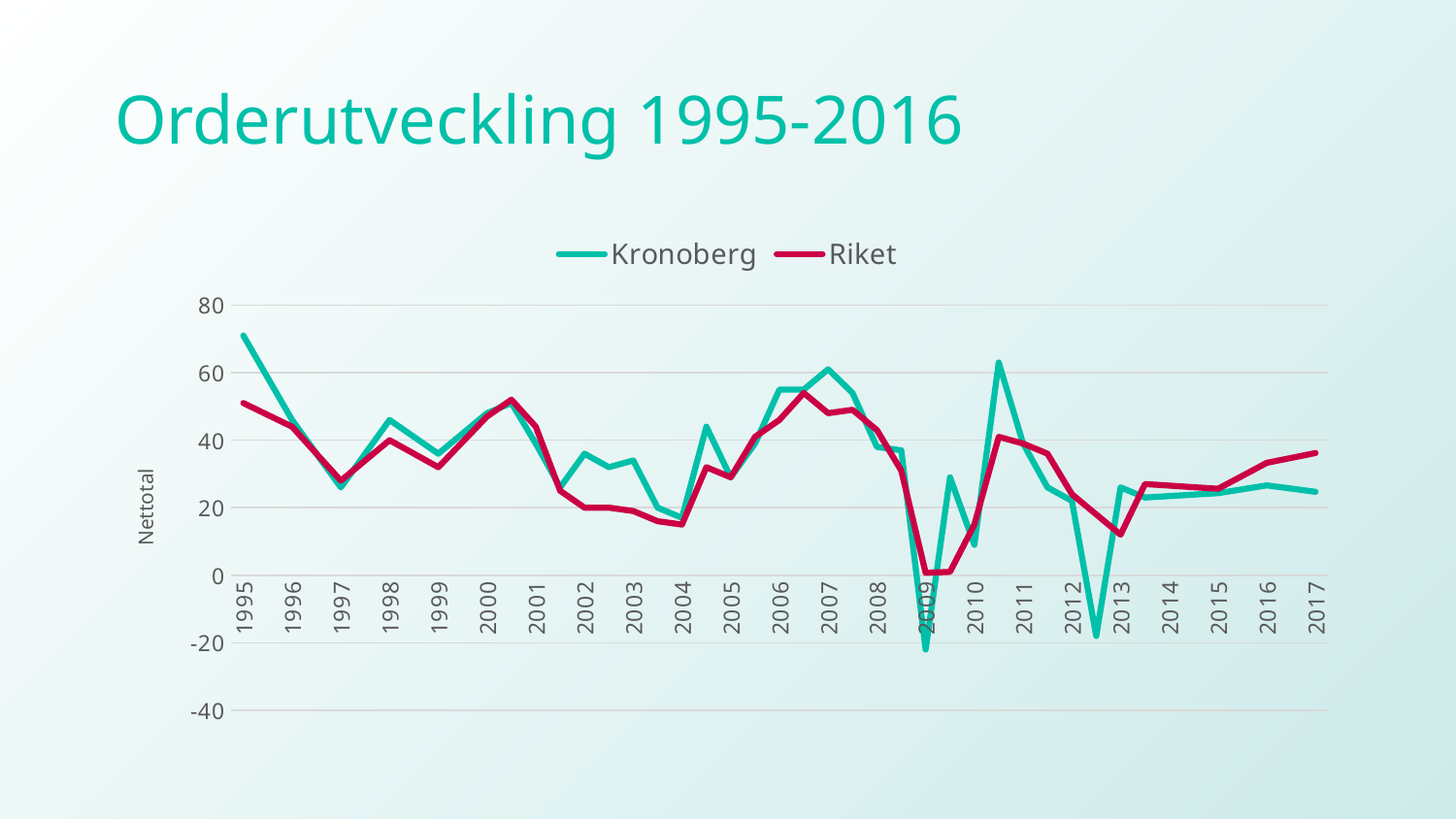
What is the label on the vertical axis? Nettotal Is the Kronoberg value for 1995 greater or less than 60? greater Which two series are shown in the legend? Kronoberg and Riket In 1995, which series has the higher value, Kronoberg or Riket? Kronoberg Is the Kronoberg value for 2009 greater or less than 0? less Is the Riket value for 1995 greater or less than 40? greater In 2017, which series has the higher value, Kronoberg or Riket? Riket How many years are labelled along the x axis? 23 Does the Riket line rise or fall between 2013 and 2017? rise What kind of chart is shown on the slide? line chart How many series does the legend list? 2